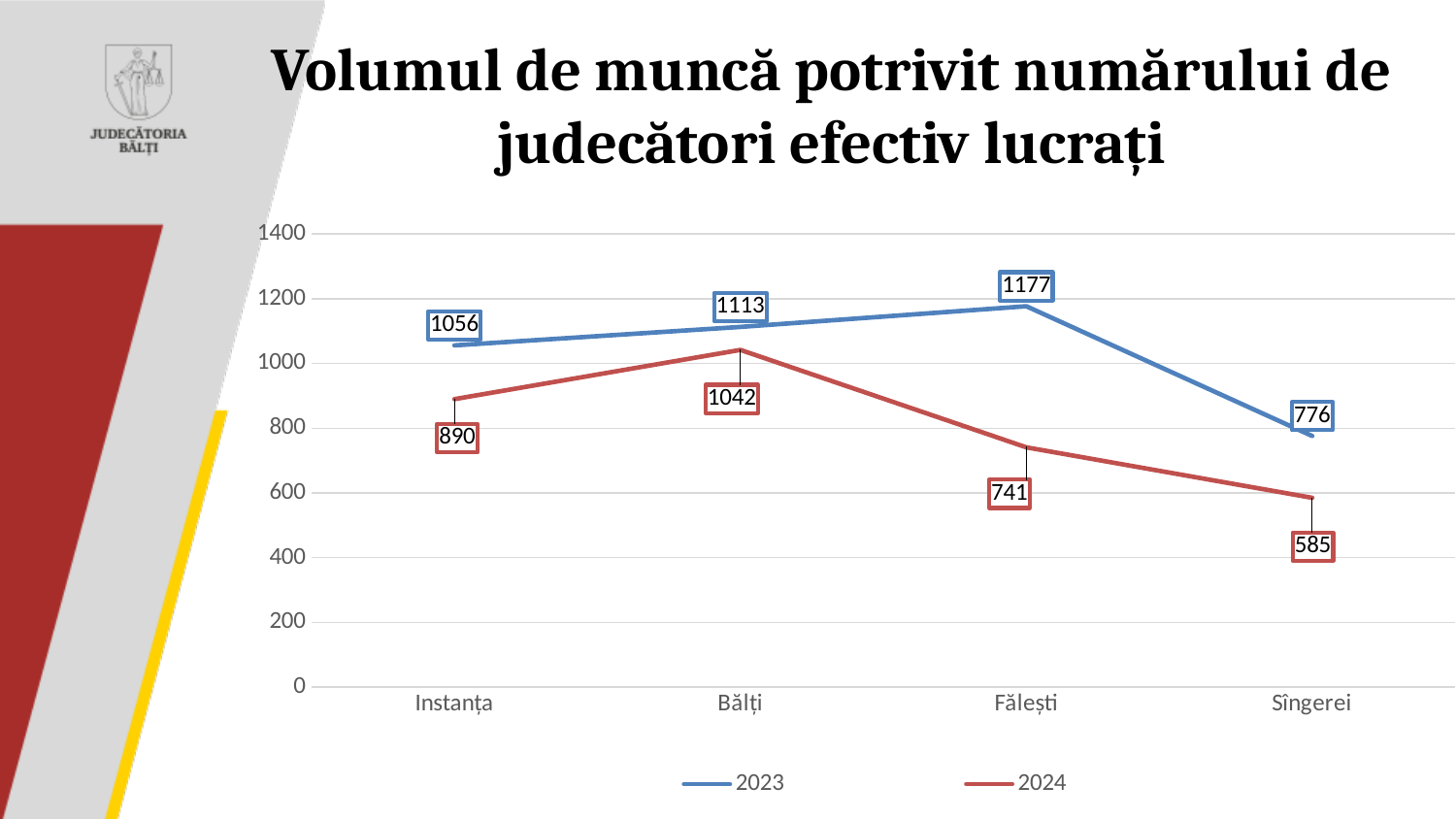
Which category has the highest 2023 value? Fălești What kind of chart is shown on the slide? line chart What is the 2024 value for Bălți? 1042 What is the 2024 value for Sîngerei? 585 What is the 2023 value for Fălești? 1177 What is the difference between the 2023 and 2024 values for Instanța? 166 How many series does the legend list? 2 Which category has the lowest 2024 value? Sîngerei How many categories are shown on the x axis? 4 What is the difference between the 2023 and 2024 values for Fălești? 436 Does the 2024 series rise or fall from Bălți to Sîngerei? fall Which is larger for Bălți, the 2023 value or the 2024 value? 2023